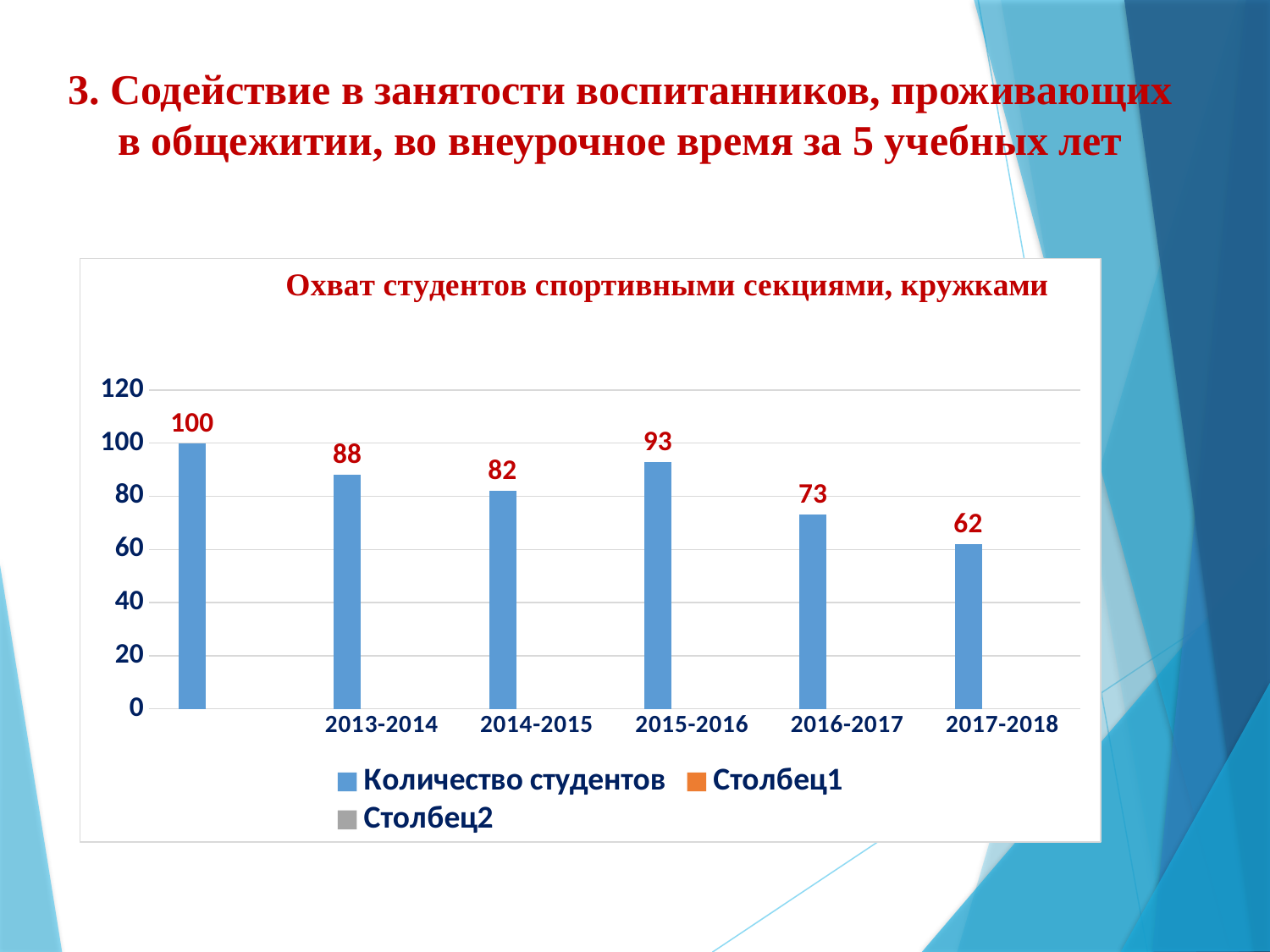
Is the value for 2016-2017 greater or less than 80? less What is the difference between the values for 2015-2016 and 2016-2017? 20 What is the value for 2015-2016? 93 How many bars are plotted on the chart? 6 What is the highest value shown on the chart? 100 Which labelled year has the lowest value? 2017-2018 How many series does the legend list? 3 What is the value for 2013-2014? 88 Which is larger, the value for 2014-2015 or the value for 2015-2016? 2015-2016 What is the value for 2016-2017? 73 What kind of chart is shown? bar chart What is the value for 2017-2018? 62